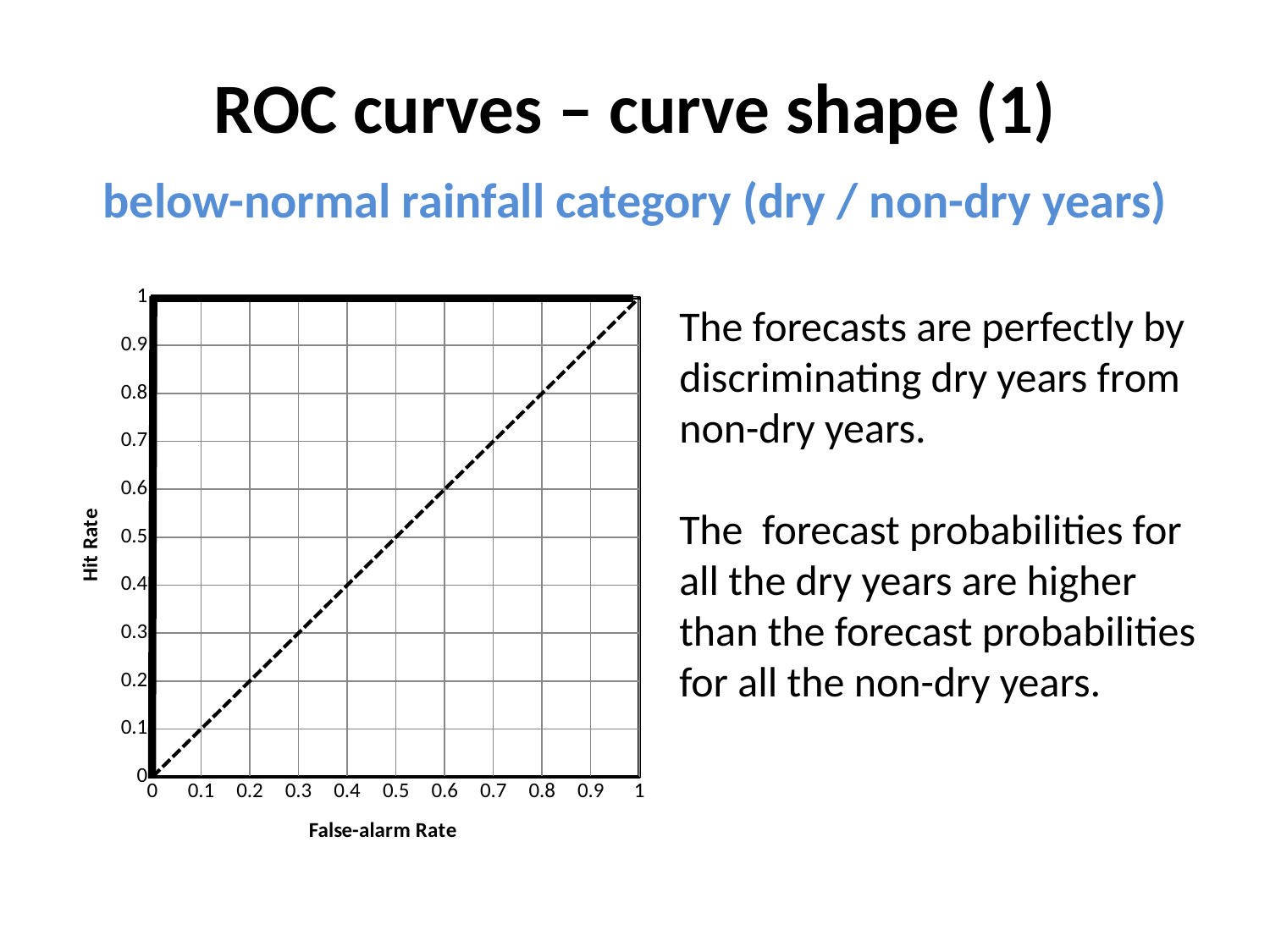
At a false-alarm rate of 0.3, is the hit rate of the solid ROC curve greater or less than 0.9? greater Does the hit rate of the dashed diagonal line rise or fall as the false-alarm rate increases? rise At a false-alarm rate of 0.4, which line has the higher hit rate, the solid ROC curve or the dashed diagonal line? the solid ROC curve At a false-alarm rate of 0.2, is the hit rate of the dashed diagonal line greater or less than 0.5? less How many lines are plotted on the chart? 2 What is the label of the x axis of the chart? False-alarm Rate What is the hit rate of the dashed diagonal line at a false-alarm rate of 0.5? 0.5 What is the hit rate of the solid ROC curve at a false-alarm rate of 0.5? 1 What is the hit rate of the dashed diagonal line at a false-alarm rate of 0.8? 0.8 What is the label of the y axis of the chart? Hit Rate What kind of chart is shown on the slide? line chart What is the maximum value shown on the y axis of the chart? 1